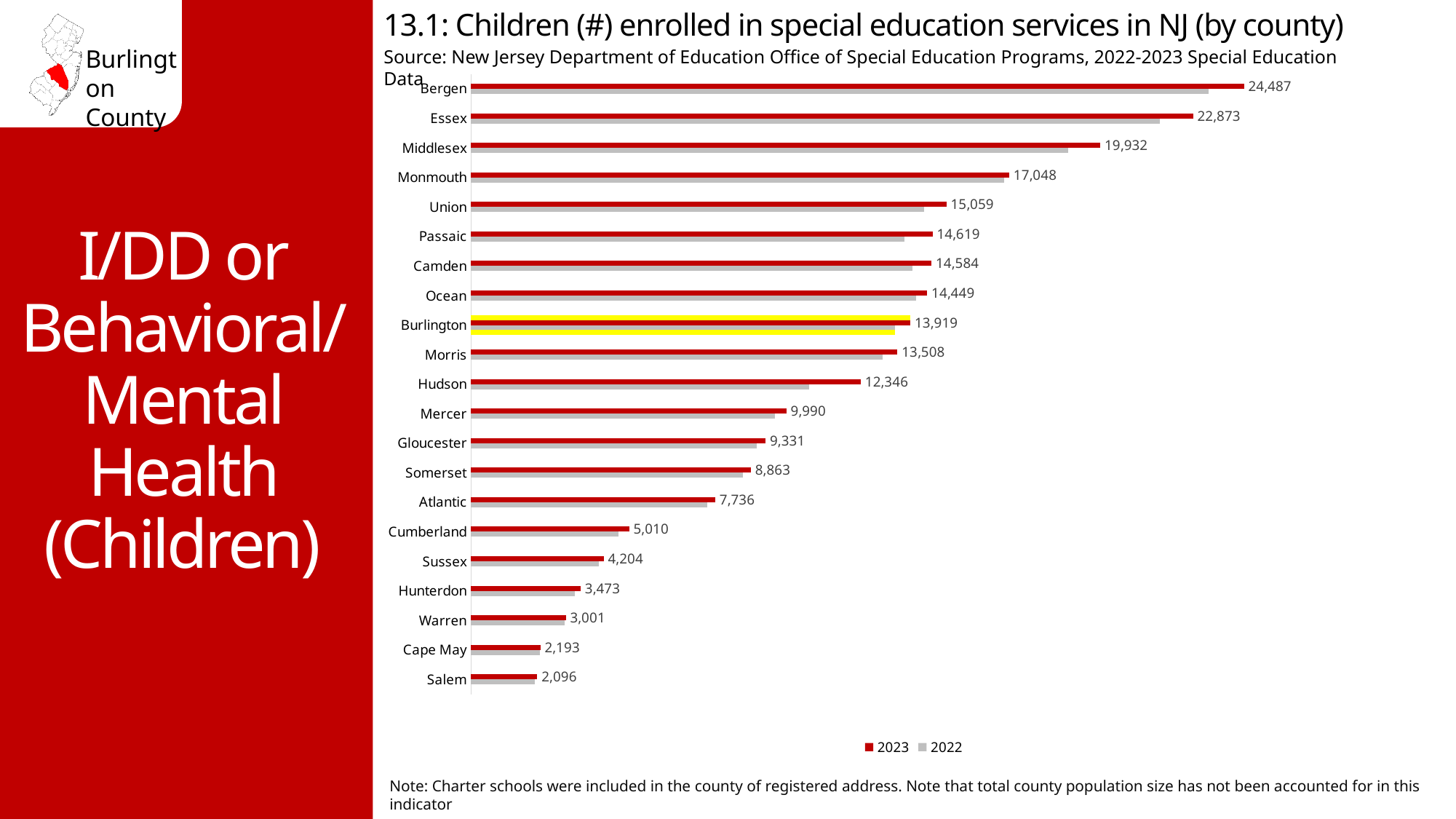
Which year does the red bar represent according to the legend? 2023 What is the 2023 value for Cumberland County? 5,010 What is the 2023 value for Middlesex County? 19,932 Which is larger for Hudson County, the 2023 value or the 2022 value? 2023 What is the 2023 number of children enrolled in special education services in Burlington County? 13,919 Which county has the highest 2023 value? Bergen How many series does the legend list? 2 How many counties are listed on the chart? 21 Which county has the lowest 2023 value? Salem What type of chart is shown on the slide? bar chart What is the difference between the 2023 values for Bergen and Essex? 1,614 What is the difference between the 2023 values for Burlington and Morris? 411